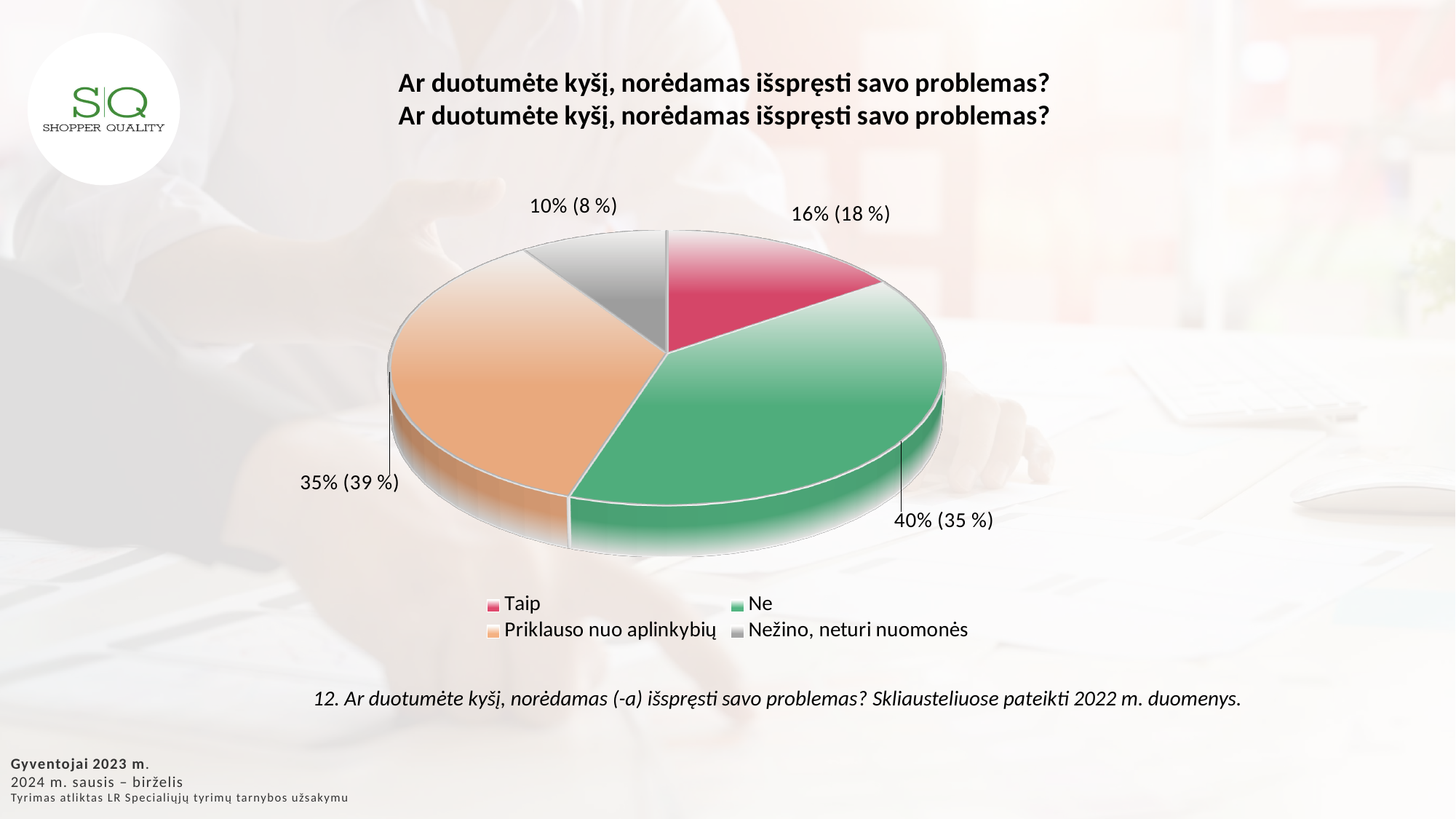
By how many percentage points does the 2023 value for "Ne" exceed the 2023 value for "Priklauso nuo aplinkybių"? 5 percentage points Which answer category has the largest slice of the pie chart? Ne What is the 2022 value shown in parentheses for "Nežino, neturi nuomonės"? 8 % What is the 2023 value shown for "Priklauso nuo aplinkybių"? 35% Which answer category has the smallest slice of the pie chart? Nežino, neturi nuomonės What percentage of respondents answered "Taip" in 2023 according to the pie chart? 16% How many categories does the pie chart show? 4 What type of chart is shown on the slide? Pie chart Which colour represents "Priklauso nuo aplinkybių" in the pie chart? Orange Which is larger in 2023: the share for "Taip" or the share for "Nežino, neturi nuomonės"? Taip What percentage of respondents answered "Ne" in 2023 according to the pie chart? 40% What share of the pie does the "Ne" slice represent in 2023? 40%